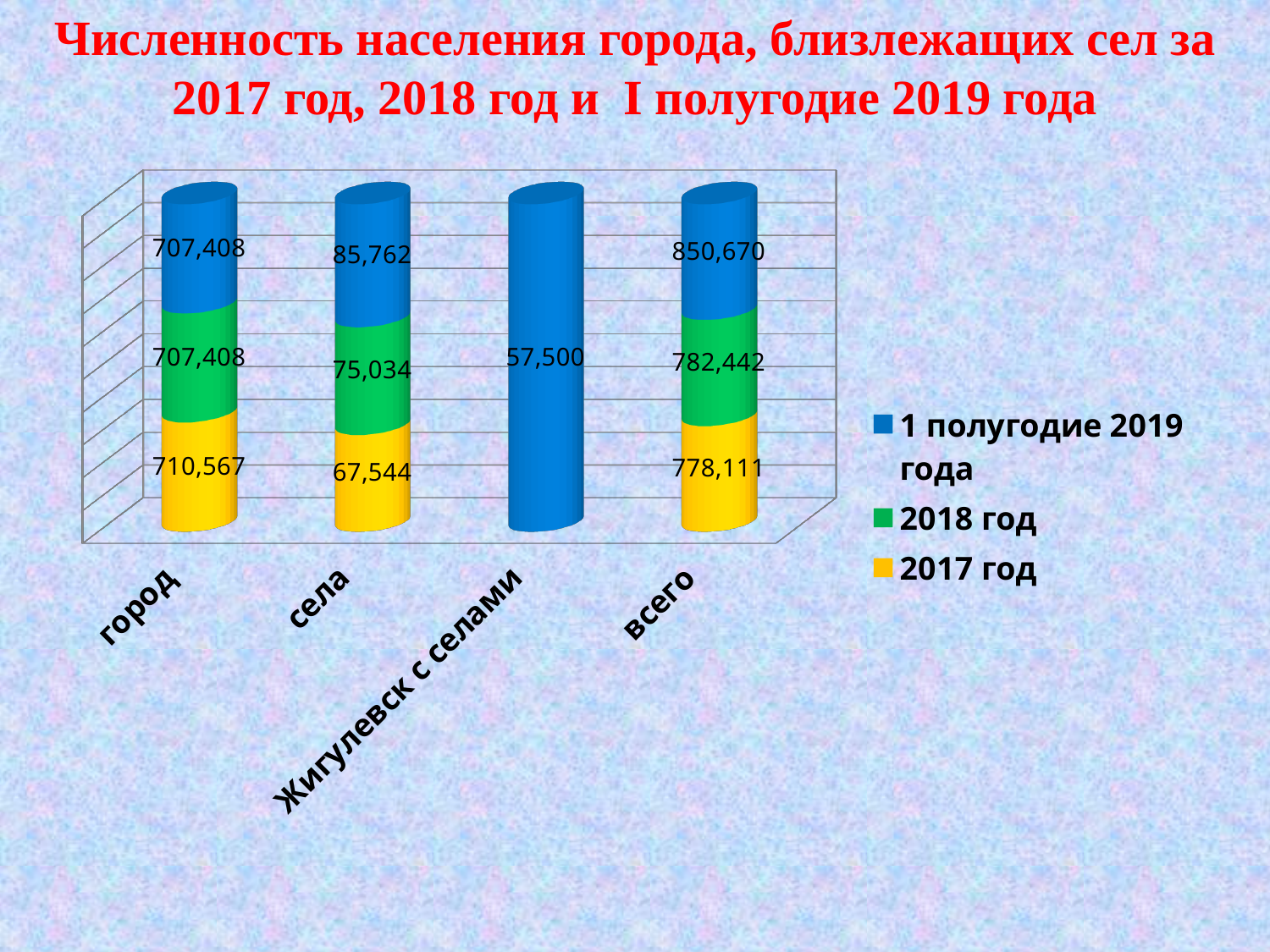
How many series does the legend list? 3 How many categories are shown on the x axis? 4 Which category has the highest value in the '2017 год' series? всего What kind of chart is shown on the slide? Stacked bar chart Which category has the lowest value in the '2018 год' series? села What is the value shown for 'Жигулевск с селами'? 57,500 What is the value for 'город' in the '2017 год' series? 710,567 What is the value for 'села' in the '2018 год' series? 75,034 What is the value for 'всего' in the '1 полугодие 2019 года' series? 850,670 Which is larger for 'город': the '2017 год' value or the '2018 год' value? 2017 год What is the difference between the '1 полугодие 2019 года' and '2017 год' values for 'села'? 18,218 What is the difference between the '2018 год' and '2017 год' values for 'всего'? 4,331